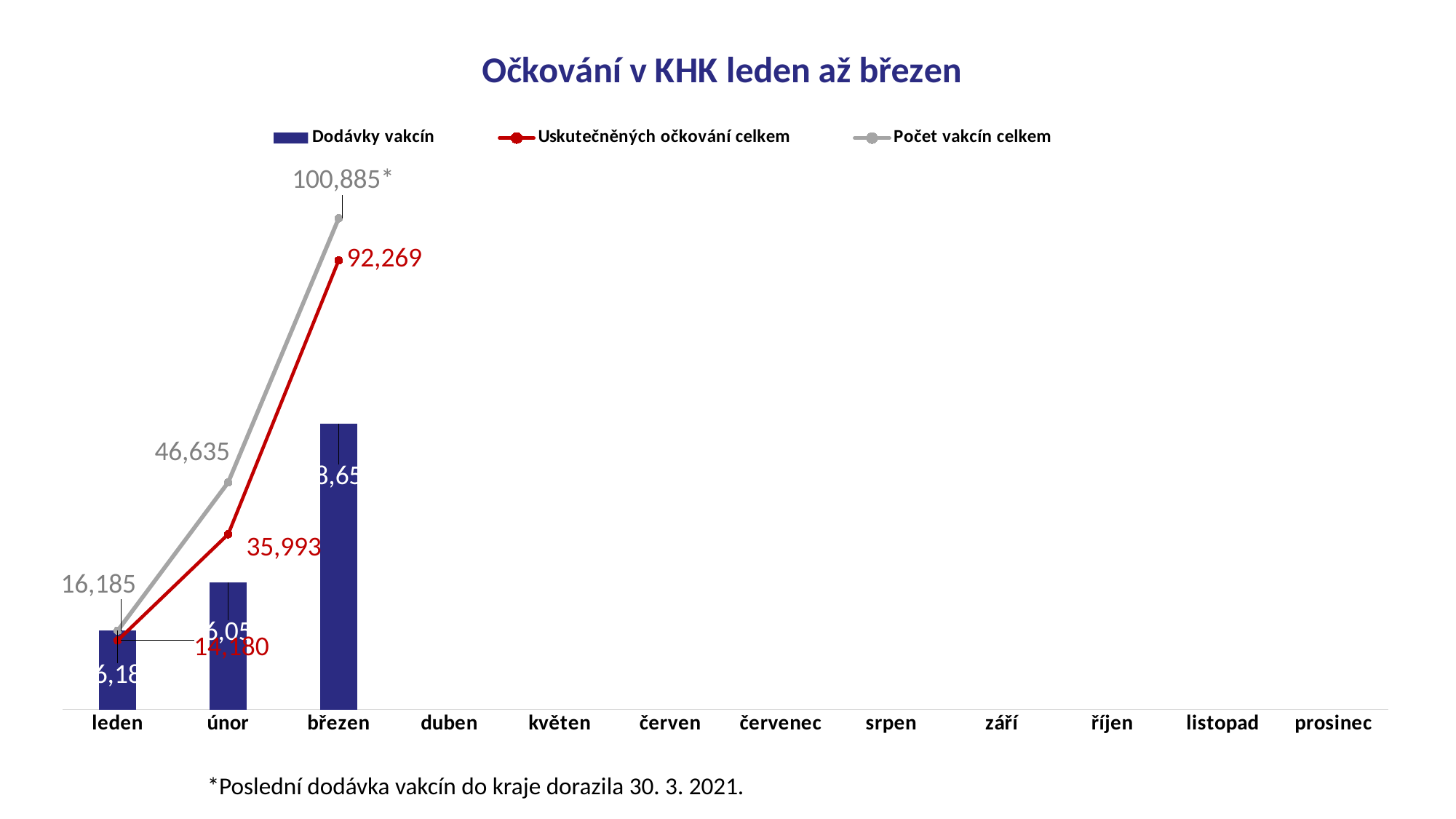
What is the difference between Počet vakcín celkem and Uskutečněných očkování celkem in březen? 8,616 What is the value of Počet vakcín celkem for leden? 16,185 What is the value of Uskutečněných očkování celkem for leden? 14,180 Which month has the highest value of Uskutečněných očkování celkem? březen How many series does the legend list? 3 What is the value of Uskutečněných očkování celkem for březen? 92,269 What is the value of Uskutečněných očkování celkem for únor? 35,993 What is the value of Počet vakcín celkem for únor? 46,635 Does the Počet vakcín celkem line rise or fall from leden to březen? rise In únor, which is larger: Počet vakcín celkem or Uskutečněných očkování celkem? Počet vakcín celkem How many month categories are shown on the x axis? 12 By how much did Uskutečněných očkování celkem increase from únor to březen? 56,276